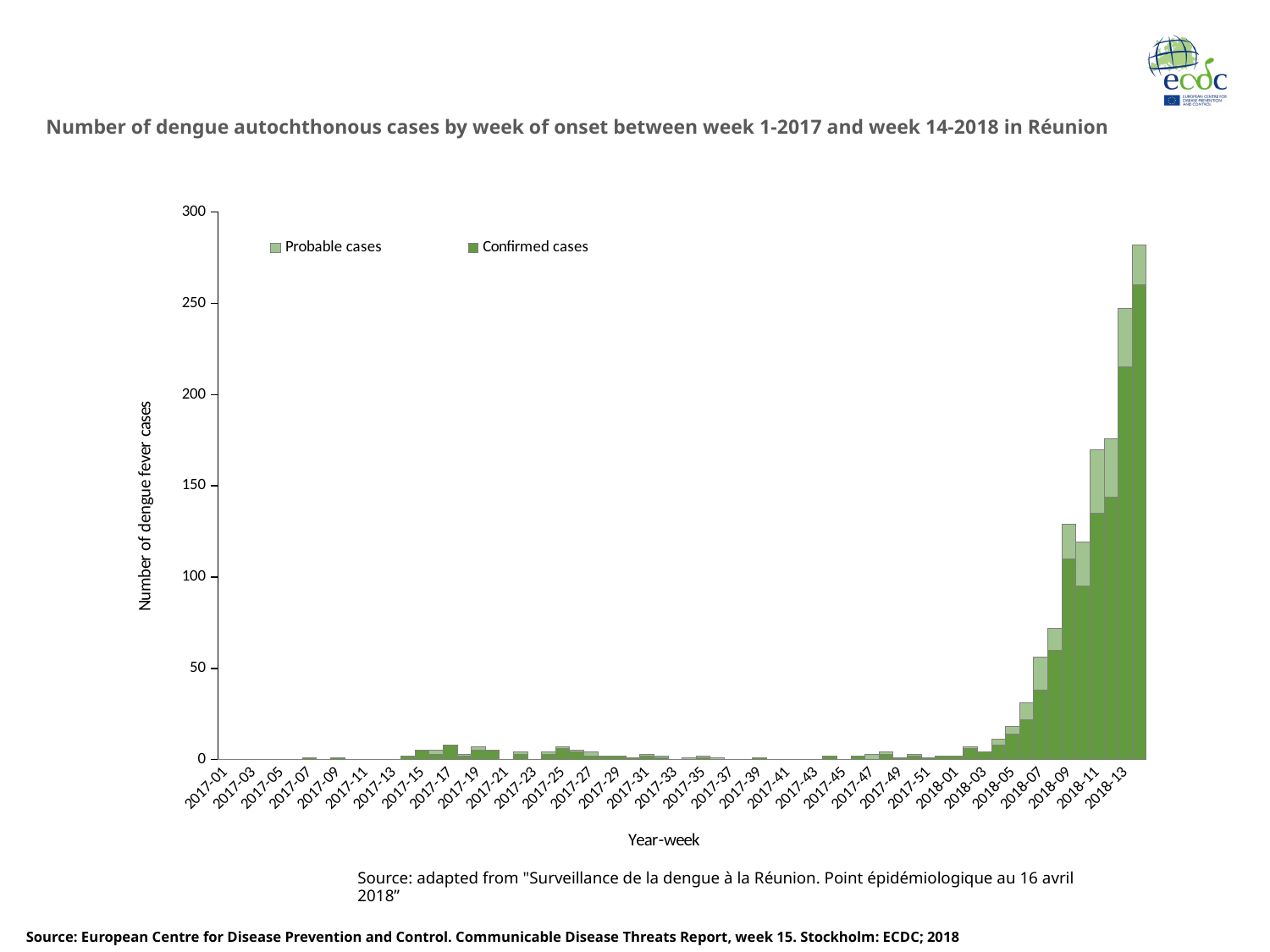
Do the weekly case numbers rise or fall toward the right end of the x axis? Rise What type of chart is shown on the slide? Stacked bar chart Are the highest weekly totals found in 2017 or in 2018? 2018 What are the two series named in the legend? Probable cases and Confirmed cases Is the total for 2018-13 greater or less than 200? greater How many series does the legend list? 2 Is the value for 2018-01 greater or less than 50? less Is the value for 2017-01 greater or less than 50? less In the tallest bars, which series makes up the larger part: Probable cases or Confirmed cases? Confirmed cases What is the title of the vertical axis? Number of dengue fever cases Which has the larger value, 2017-13 or 2018-13? 2018-13